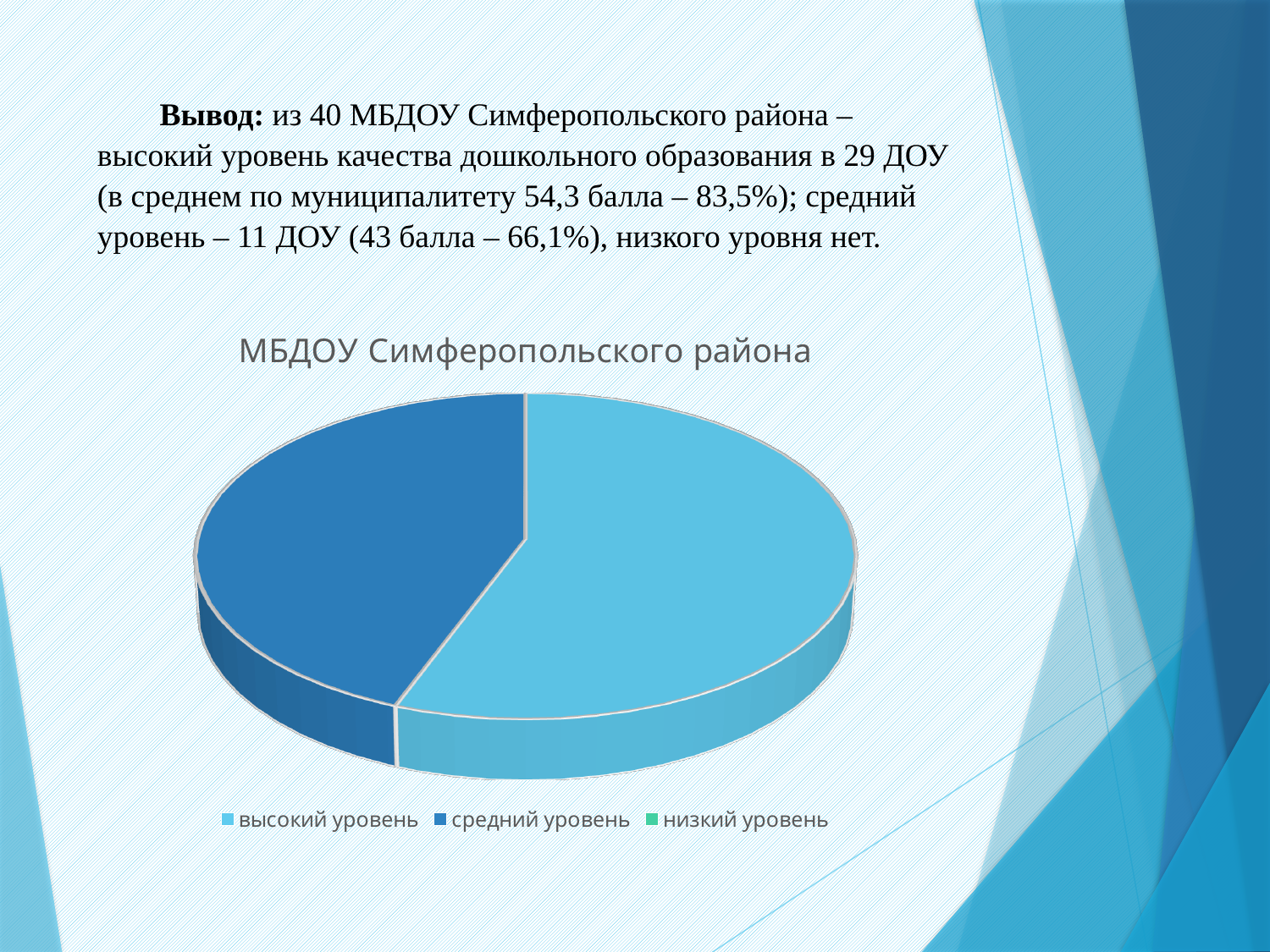
Is the share of the pie for средний уровень greater or less than 50%? less How many slices are visible in the pie? 2 What kind of chart is shown on the slide? pie chart Which category has the largest slice of the pie? высокий уровень What colour is the slice for средний уровень? dark blue Which slice is larger: высокий уровень or средний уровень? высокий уровень Is the share of the pie for высокий уровень greater or less than 50%? greater What is the title of the chart? МБДОУ Симферопольского района Which legend entry has no visible slice in the pie? низкий уровень How many entries does the chart's legend list? 3